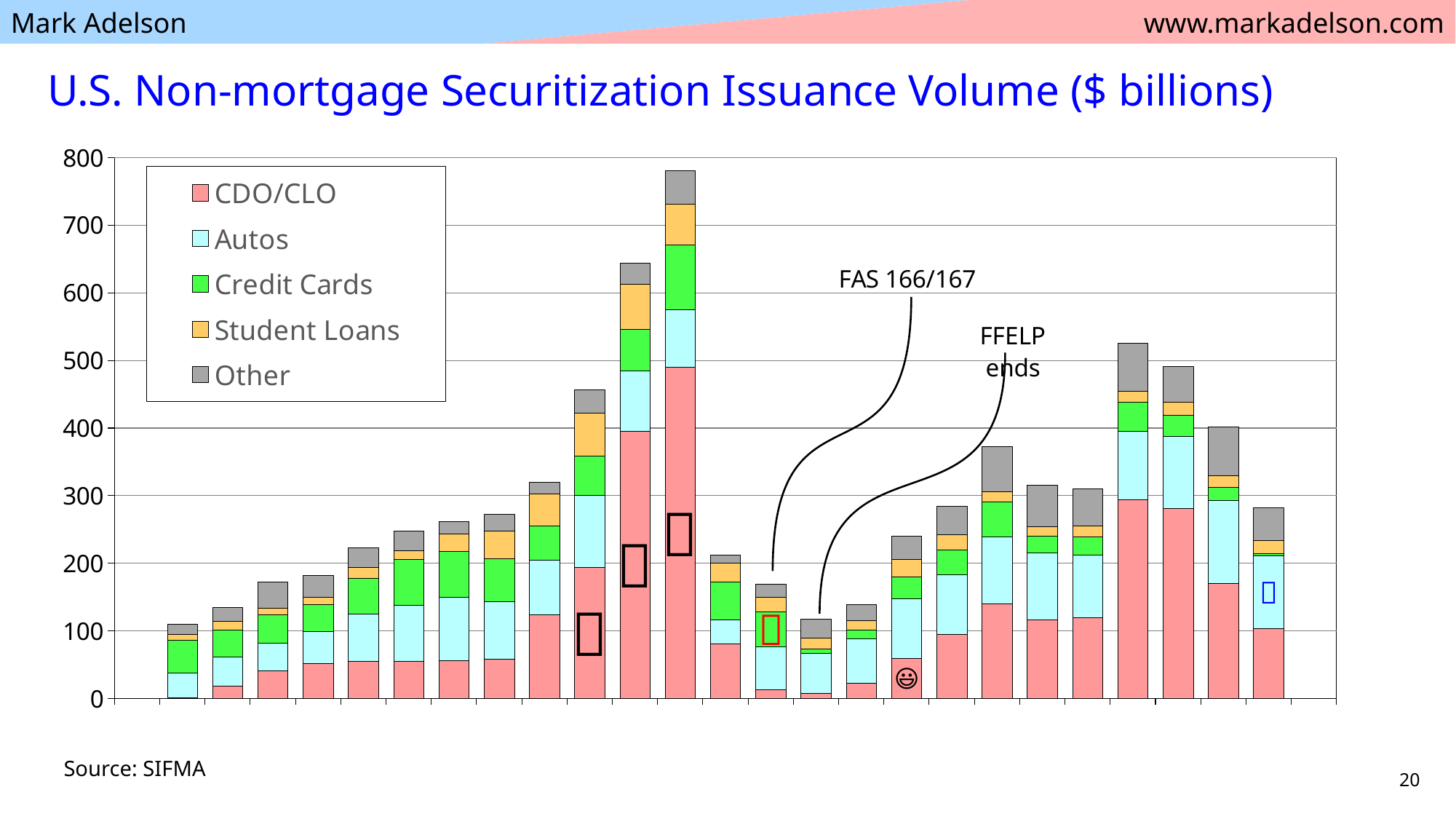
How many series does the legend list? 5 What kind of chart is shown on the slide? Stacked bar chart Is the total of the tallest bar greater or less than 700? greater Is the CDO/CLO segment of the tallest bar greater or less than 400? greater Is the total of the leftmost bar greater or less than 200? less Which series is shown at the bottom of each stacked bar? CDO/CLO Which bar has the larger total, the leftmost bar or the rightmost bar? The rightmost bar How many stacked bars are plotted in the chart? 25 What is the title of the chart? U.S. Non-mortgage Securitization Issuance Volume ($ billions) Do the bar totals rise or fall from the leftmost bar up to the tallest bar? rise